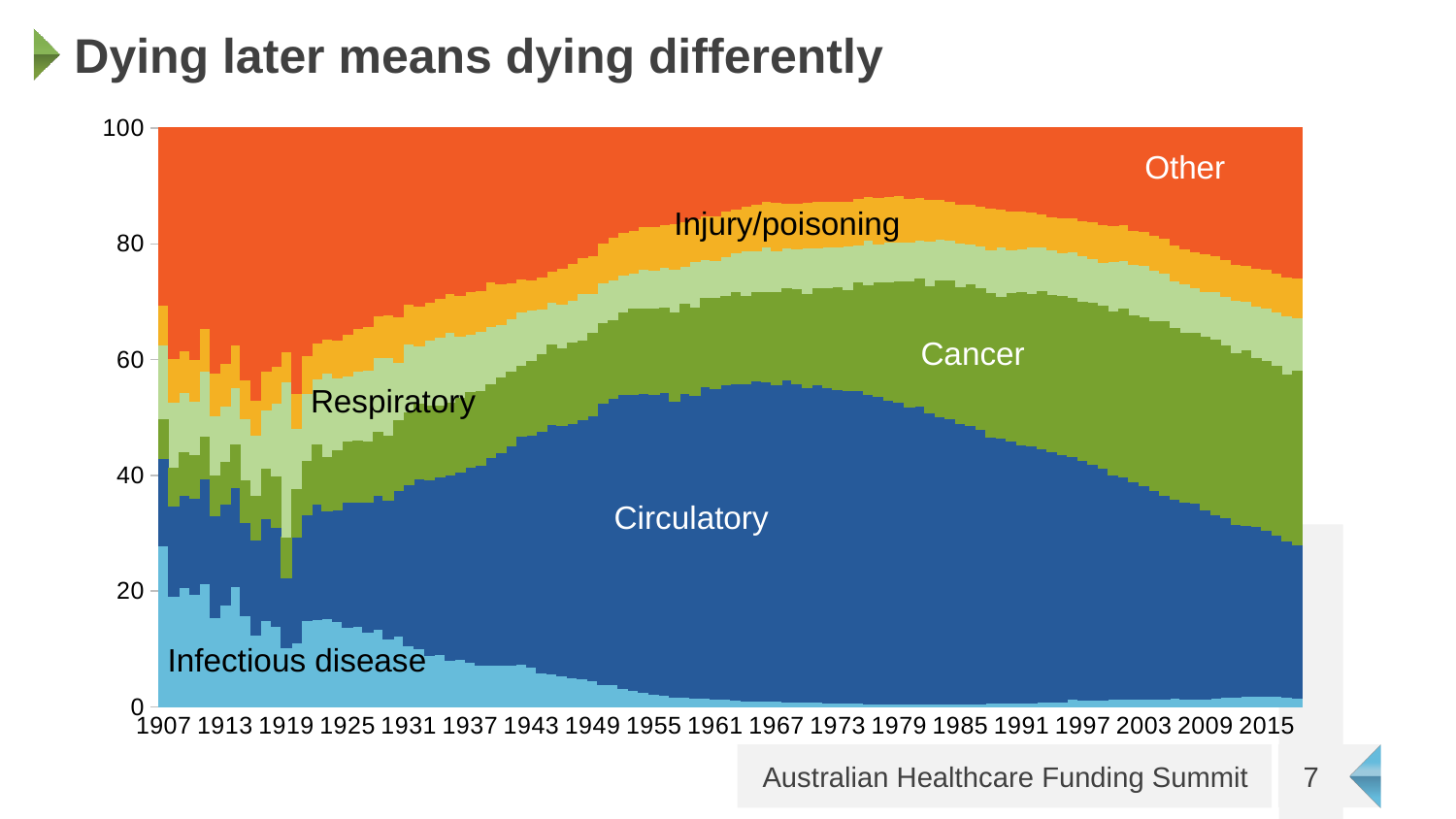
In 1907, which is larger: the share for Infectious disease or the share for Circulatory? Infectious disease Does the share for Cancer rise or fall from 1907 to 2015? Rise What is the title of the slide? Dying later means dying differently Which series is plotted at the bottom of the stack? Infectious disease How many year labels are shown on the x axis? 19 Is the share for Infectious disease in 1955 greater or less than 20? less Which cause accounts for the largest share in 1967? Circulatory Does the share for Infectious disease rise or fall from 1907 to 2015? Fall How many cause-of-death series are labelled in the chart? 6 Is the share for Infectious disease in 1907 greater or less than 20? greater In 1967, which is larger: the share for Circulatory or the share for Cancer? Circulatory What kind of chart is shown on the slide? Stacked bar chart